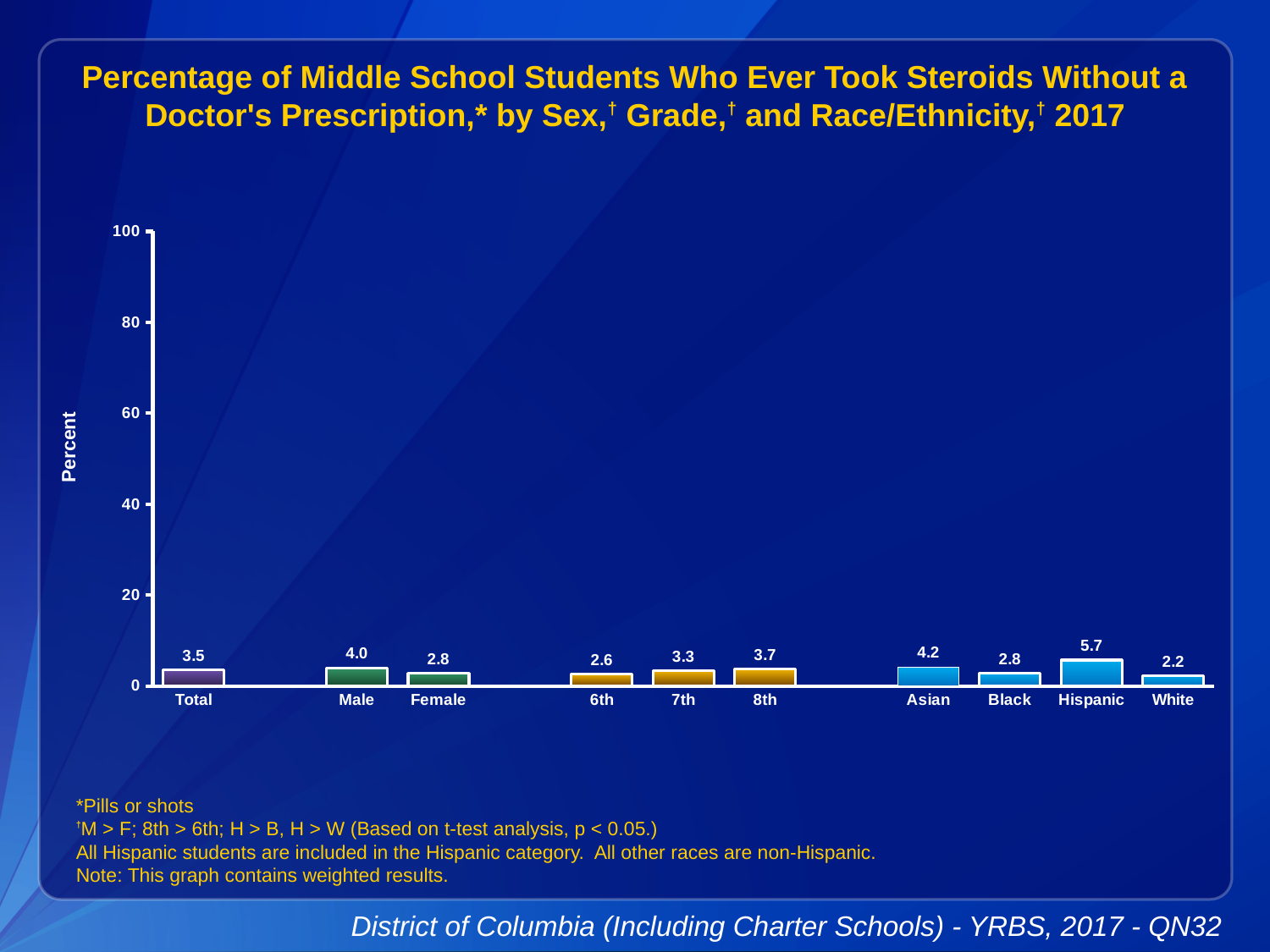
Which category has the lowest value? White Do the values rise or fall from 6th grade to 8th grade? rise What is the label on the y axis? Percent Is the value for Asian students greater or less than 20? less What is the value for Total? 3.5 Which is larger, the value for 8th grade or the value for 7th grade? 8th What kind of chart is this? bar chart What is the value for 6th grade students? 2.6 What is the difference between the Male and Female values? 1.2 Which category has the highest value? Hispanic How many categories are shown on the x axis? 10 What is the value for Hispanic students? 5.7